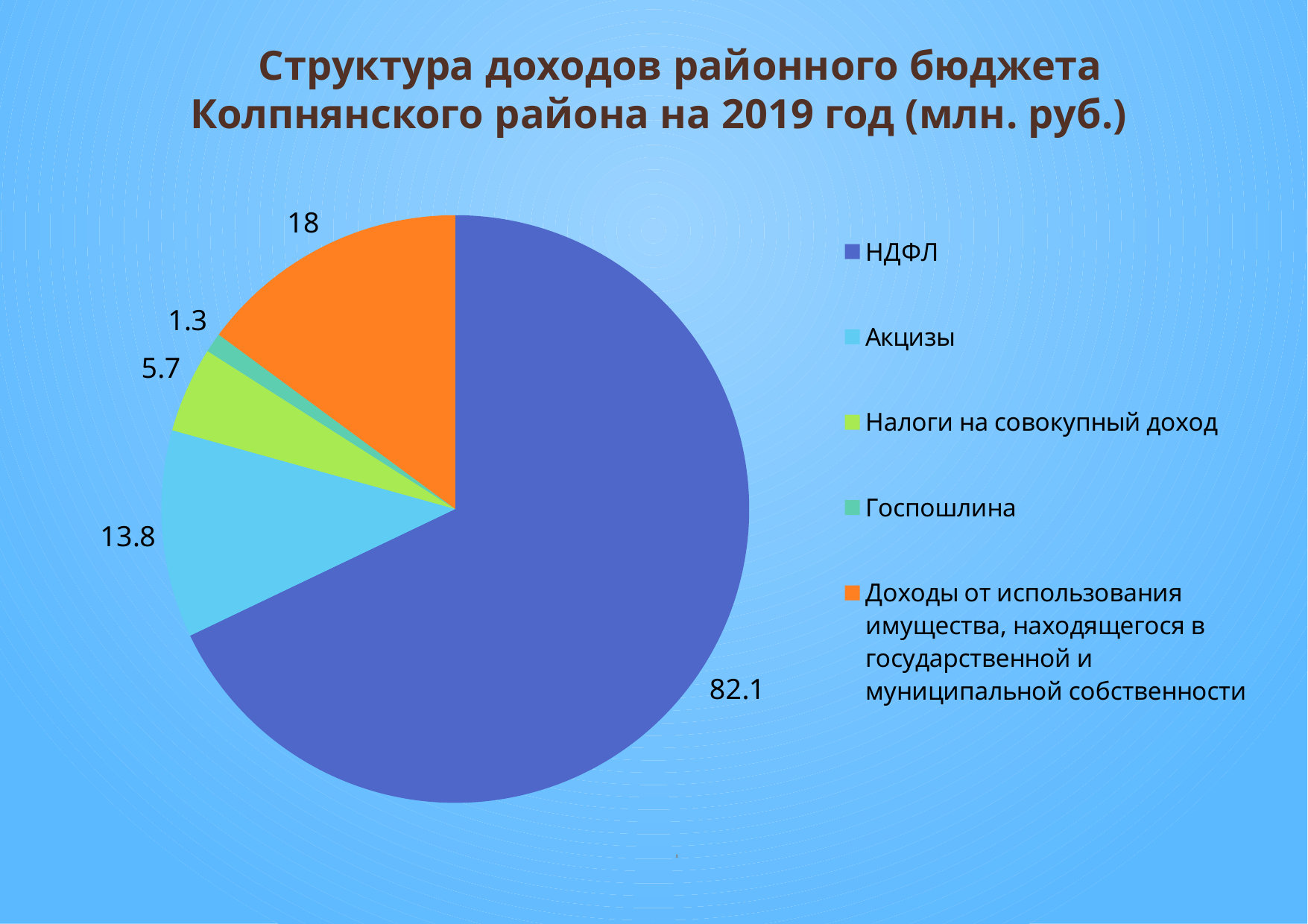
What is the value for Акцизы? 13.8 Which is larger: Акцизы or Налоги на совокупный доход? Акцизы What is the value for Госпошлина? 1.3 What type of chart is shown on the slide? pie chart Which category has the smallest slice of the pie? Госпошлина What is the value for Налоги на совокупный доход? 5.7 What is the title of the chart? Структура доходов районного бюджета Колпнянского района на 2019 год (млн. руб.) What is the difference between the values for НДФЛ and Акцизы? 68.3 What is the value for Доходы от использования имущества, находящегося в государственной и муниципальной собственности? 18 Which category has the largest slice of the pie? НДФЛ What is the value for НДФЛ? 82.1 How many categories does the legend list? 5